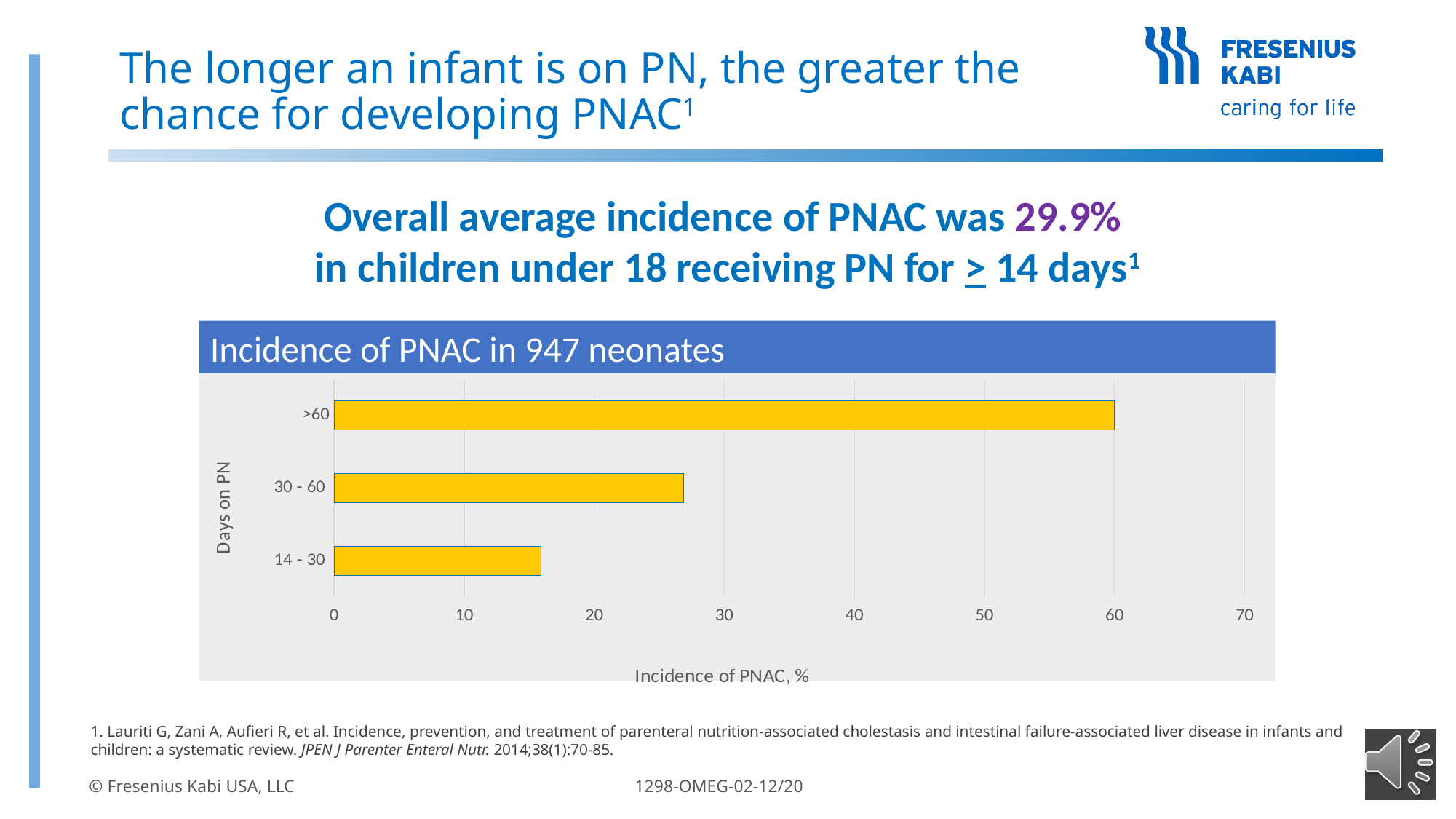
Is the incidence of PNAC for the 30 - 60 days category greater or less than 30? less How many categories of days on PN are shown in the chart? 3 What is the label of the horizontal axis of the chart? Incidence of PNAC, % Is the incidence of PNAC for the 14 - 30 days category greater or less than 20? less What is the title of the chart? Incidence of PNAC in 947 neonates Which has a higher incidence of PNAC: 30 - 60 days on PN or 14 - 30 days on PN? 30 - 60 Is the incidence of PNAC for the 14 - 30 days category greater or less than 10? greater Which days-on-PN category has the highest incidence of PNAC? >60 What kind of chart is shown on the slide? bar chart What is the incidence of PNAC, in %, for the >60 days on PN category? 60 Which days-on-PN category has the lowest incidence of PNAC? 14 - 30